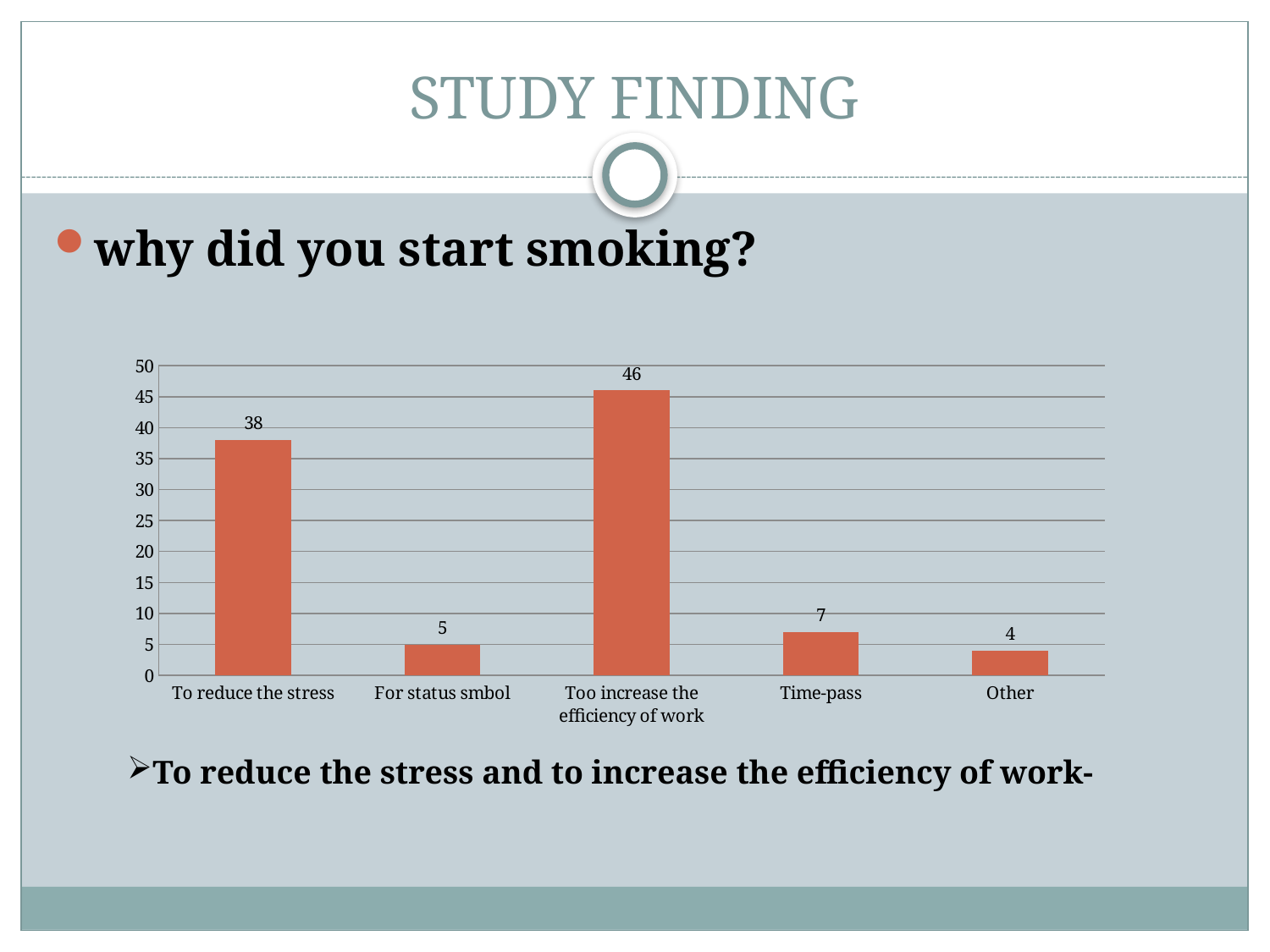
Which category has the lowest value? Other What kind of chart is shown on the slide? bar chart Which category has the highest value? Too increase the efficiency of work What is the value for "Other"? 4 How many categories are shown on the x axis? 5 What is the value for "Too increase the efficiency of work"? 46 Is the value for "To reduce the stress" greater or less than 35? greater What is the difference between the values for "Too increase the efficiency of work" and "To reduce the stress"? 8 What is the value for "To reduce the stress"? 38 Which is larger, the value for "For status smbol" or the value for "Time-pass"? Time-pass What is the value for "Time-pass"? 7 What is the total of the values for "For status smbol", "Time-pass" and "Other"? 16